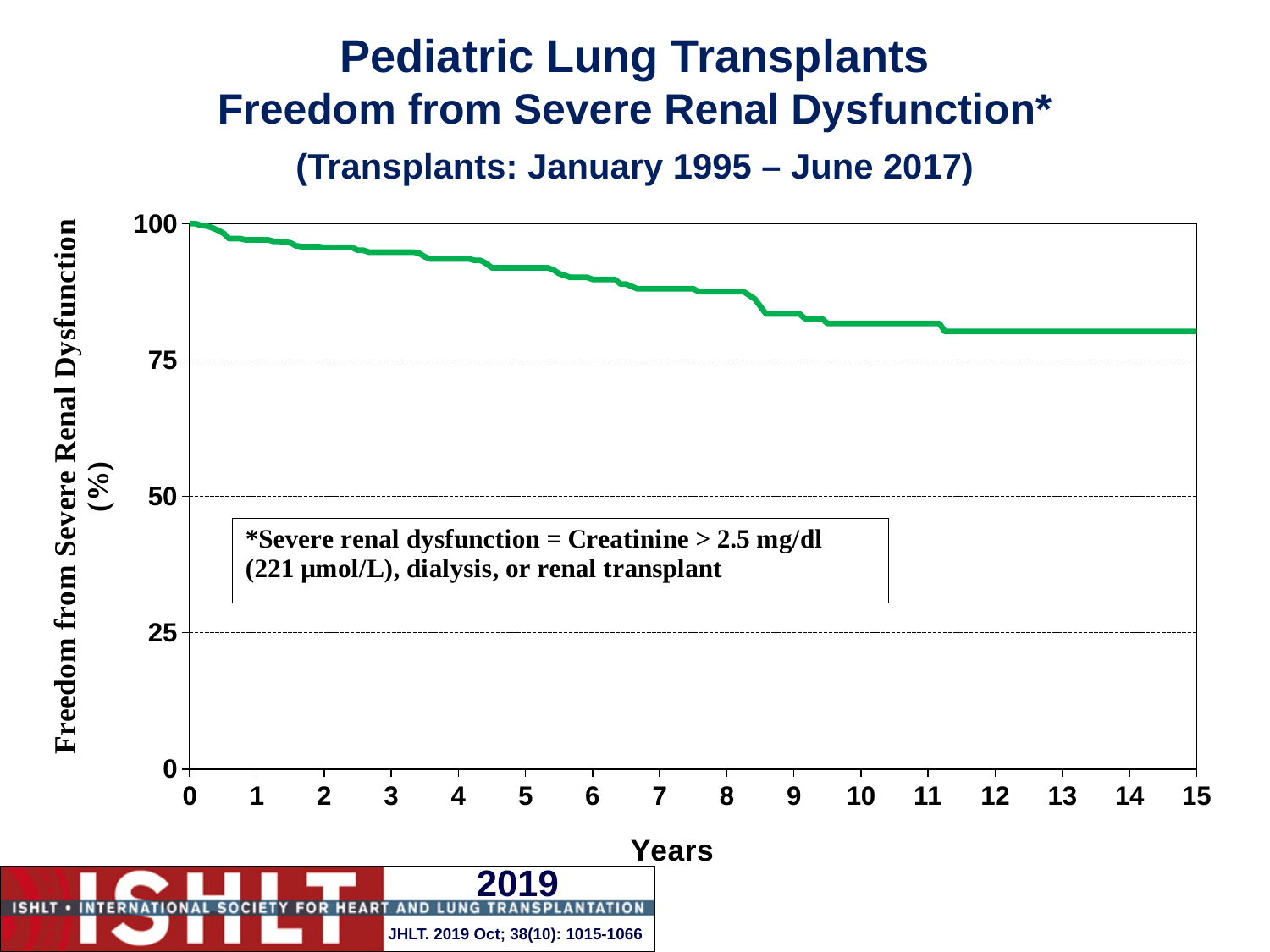
Which is higher on the curve, the value at 2 years or the value at 12 years? 2 years Is the freedom from severe renal dysfunction at 10 years greater or less than 50? greater What kind of chart is shown on the slide? line chart Is the freedom from severe renal dysfunction at 15 years greater or less than 75? greater Is the value of the curve at 8 years greater or less than 75? greater What is the label of the x axis? Years At which year shown on the x axis is the curve at its highest? 0 What is the freedom from severe renal dysfunction at 0 years? 100 What is the label of the y axis? Freedom from Severe Renal Dysfunction (%) Does the freedom from severe renal dysfunction rise or fall as years since transplant increase? fall